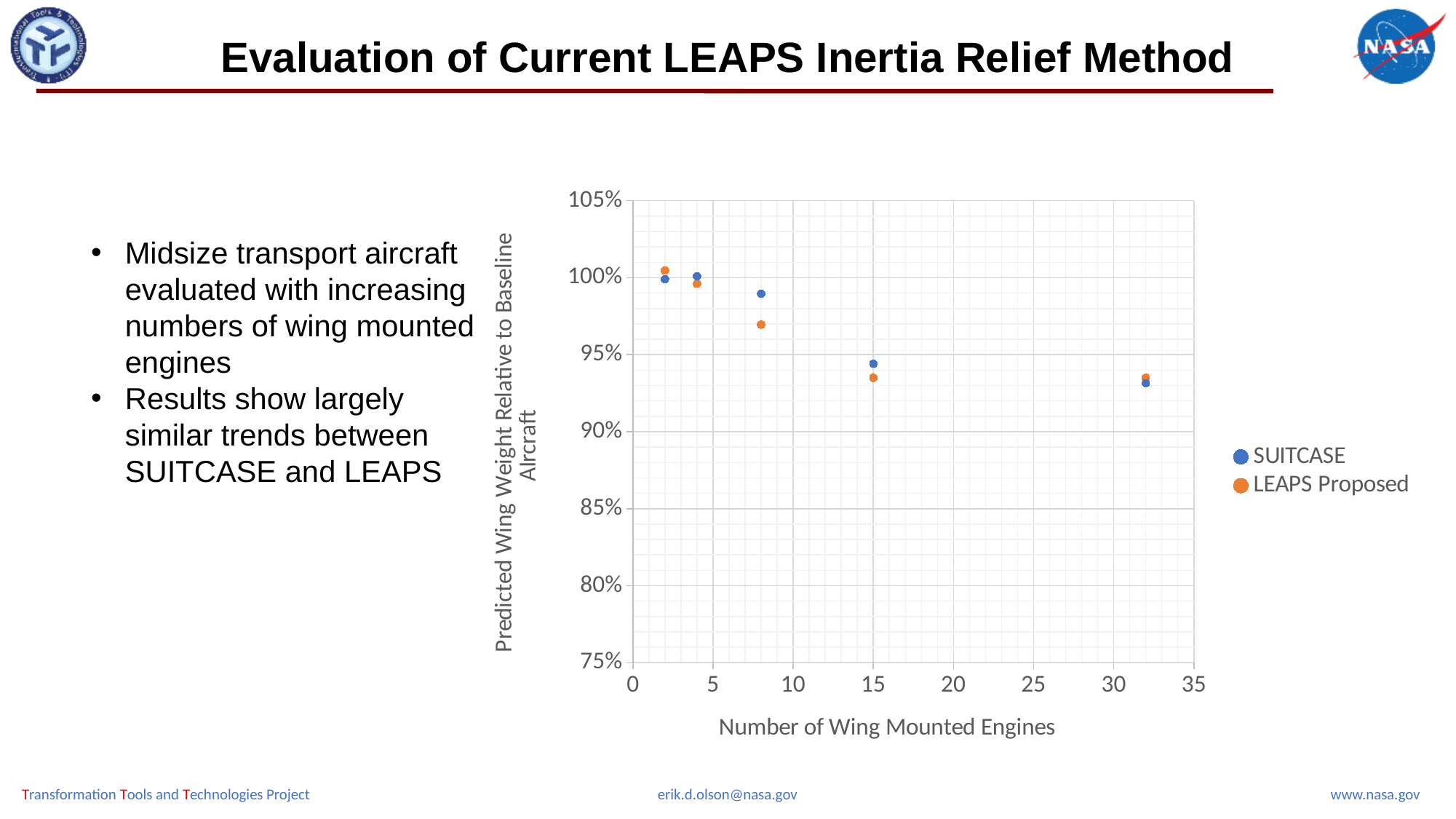
Is the SUITCASE value at 8 wing mounted engines greater or less than 95%? greater How many series does the chart legend list? 2 Which colour represents the LEAPS Proposed series in the chart? Orange What kind of chart is shown on the slide? Scatter chart Is the LEAPS Proposed value at 15 wing mounted engines greater or less than 95%? less What is the title of the x axis of the chart? Number of Wing Mounted Engines How many data points are plotted for the SUITCASE series? 5 Is the SUITCASE value at 32 wing mounted engines greater or less than 90%? greater At 8 wing mounted engines, which series has the higher predicted wing weight, SUITCASE or LEAPS Proposed? SUITCASE As the number of wing mounted engines increases, do the predicted wing weight values rise or fall? Fall